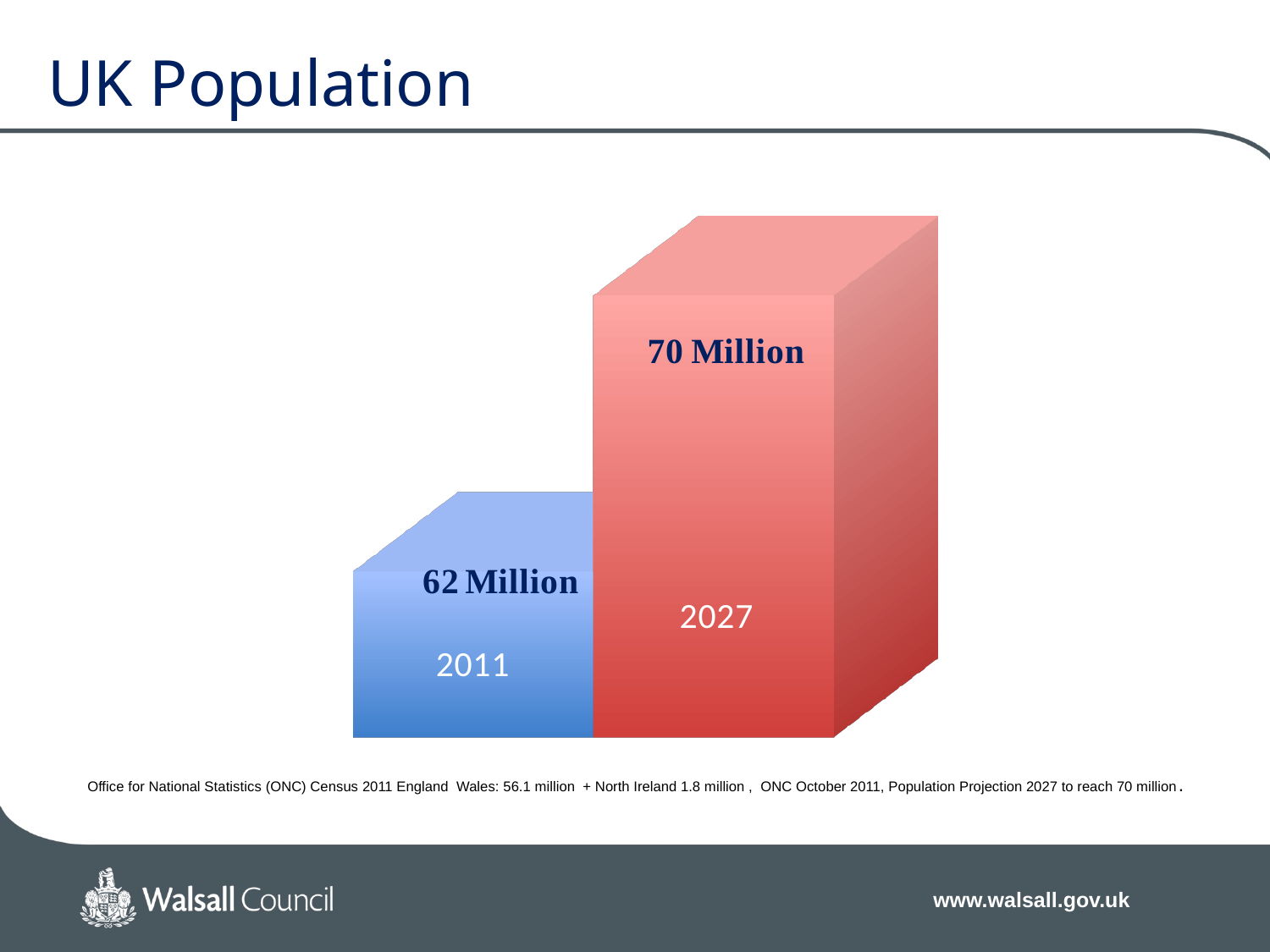
Which year has the higher population value on the chart? 2027 What is the UK population value shown for 2027? 70 Million What kind of chart is shown on the slide? bar chart How many bars are shown on the chart? 2 What colour is the bar for 2011? blue Which year has the lower population value on the chart? 2011 Is the population value for 2027 larger or smaller than the value for 2011? larger Does the population value rise or fall from 2011 to 2027? rise What is the UK population value shown for 2011? 62 Million What is the title of the slide containing the chart? UK Population What is the difference between the 2027 and 2011 population values? 8 Million